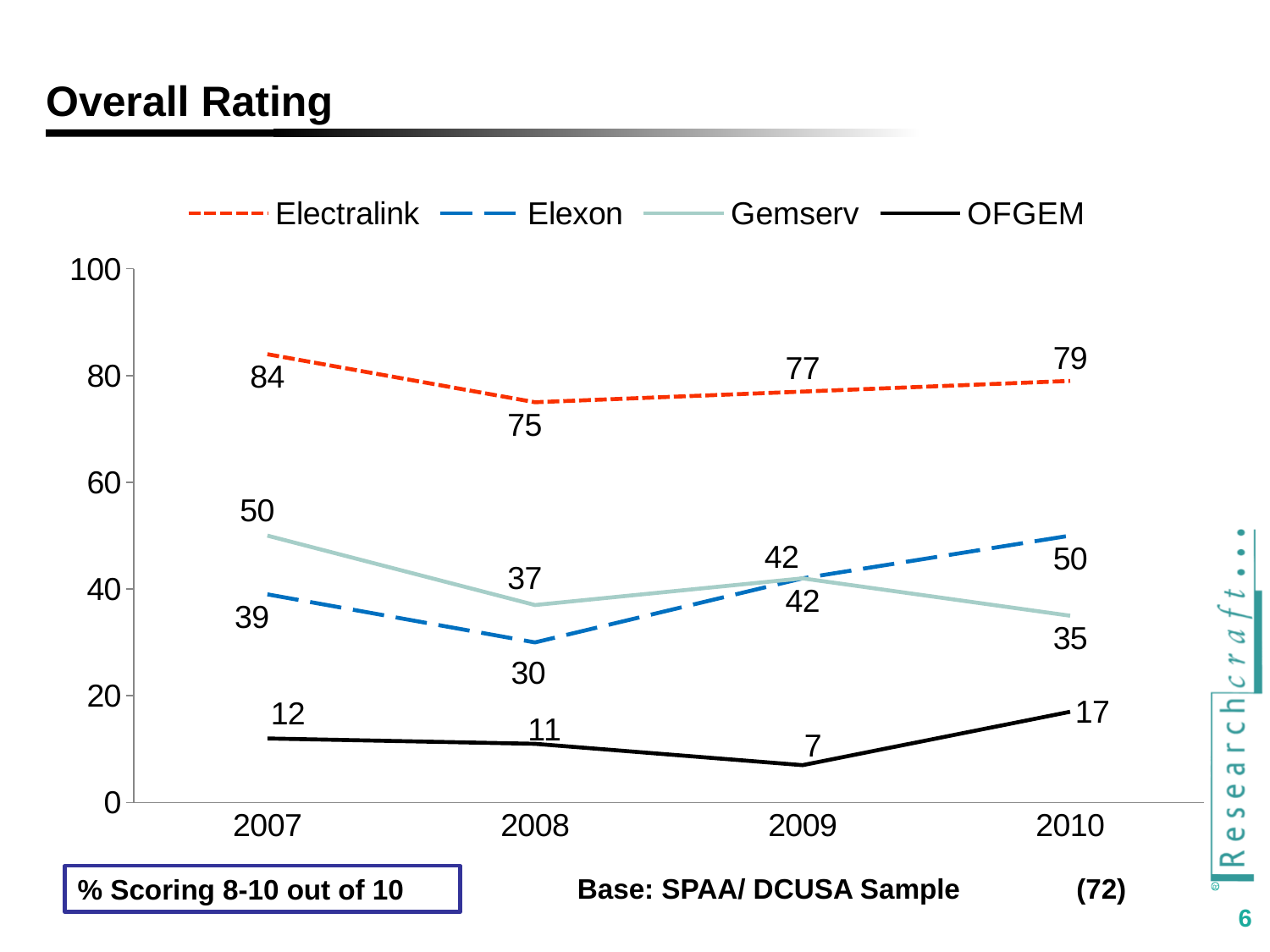
Does the OFGEM line rise or fall from 2009 to 2010? Rise What type of chart is shown on the slide? Line chart What is the value for Electralink in 2007? 84 How many series does the legend list? 4 What is the value for Elexon in 2010? 50 Which series has the highest value in 2010? Electralink How many years are shown on the x axis? 4 Which is larger in 2007, the value for Gemserv or the value for Elexon? Gemserv What is the value for Gemserv in 2008? 37 What is the value for OFGEM in 2009? 7 What is the difference between the Electralink value in 2007 and its value in 2008? 9 Which series has the lowest value in 2008? OFGEM